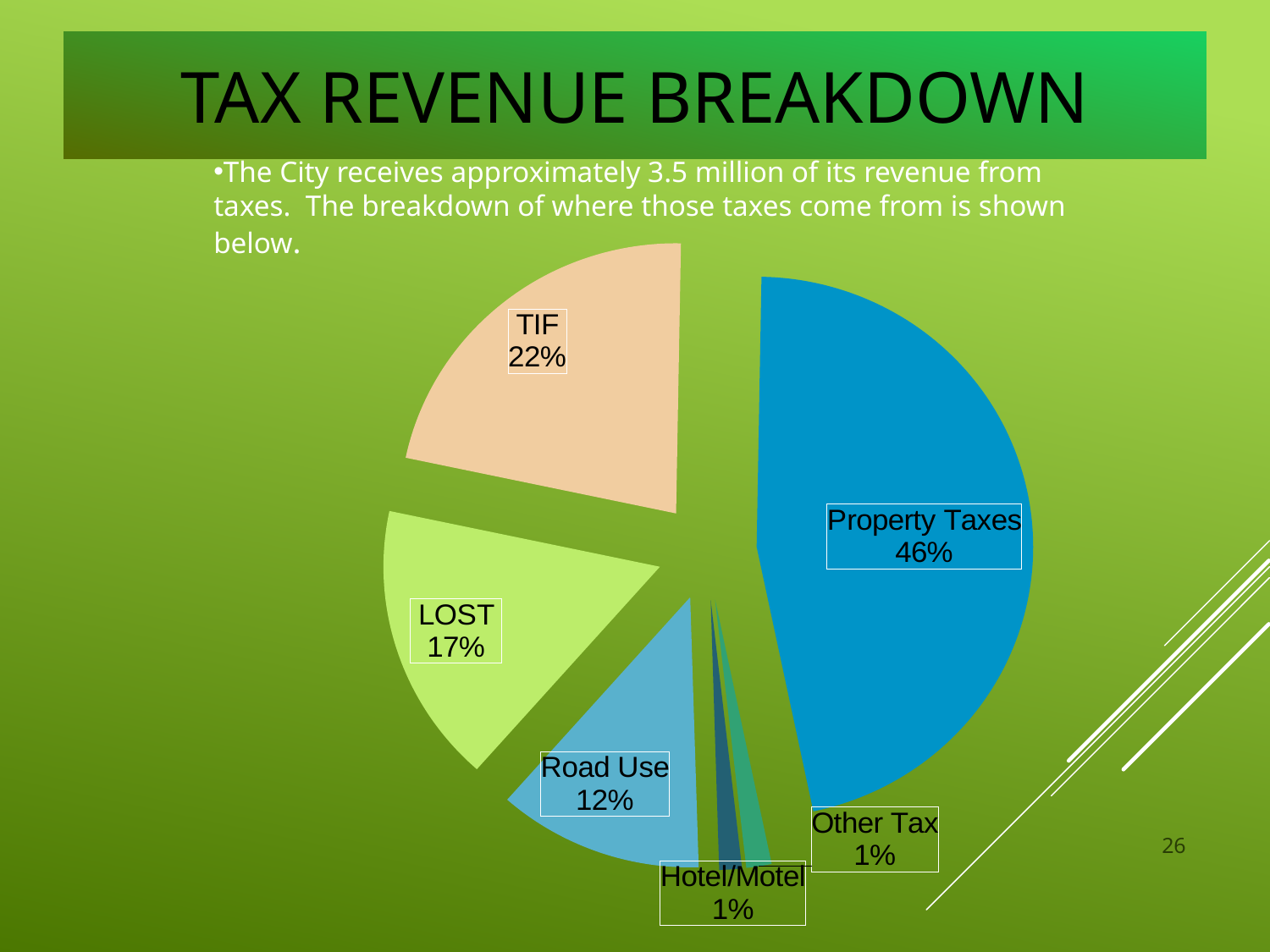
Which is larger, TIF or LOST? TIF What is the difference in percentage points between LOST and Road Use? 5 Which slice of the pie is the largest? Property Taxes What percentage does Road Use account for? 12% What percentage of the pie is TIF? 22% How many labeled slices does the pie chart have? 6 What share is shown for Hotel/Motel? 1% What share of tax revenue comes from Property Taxes? 46% What is the difference in percentage points between Property Taxes and TIF? 24 What is the title of the slide containing the pie chart? TAX REVENUE BREAKDOWN What is the value shown for LOST? 17% What kind of chart is shown on the slide? pie chart